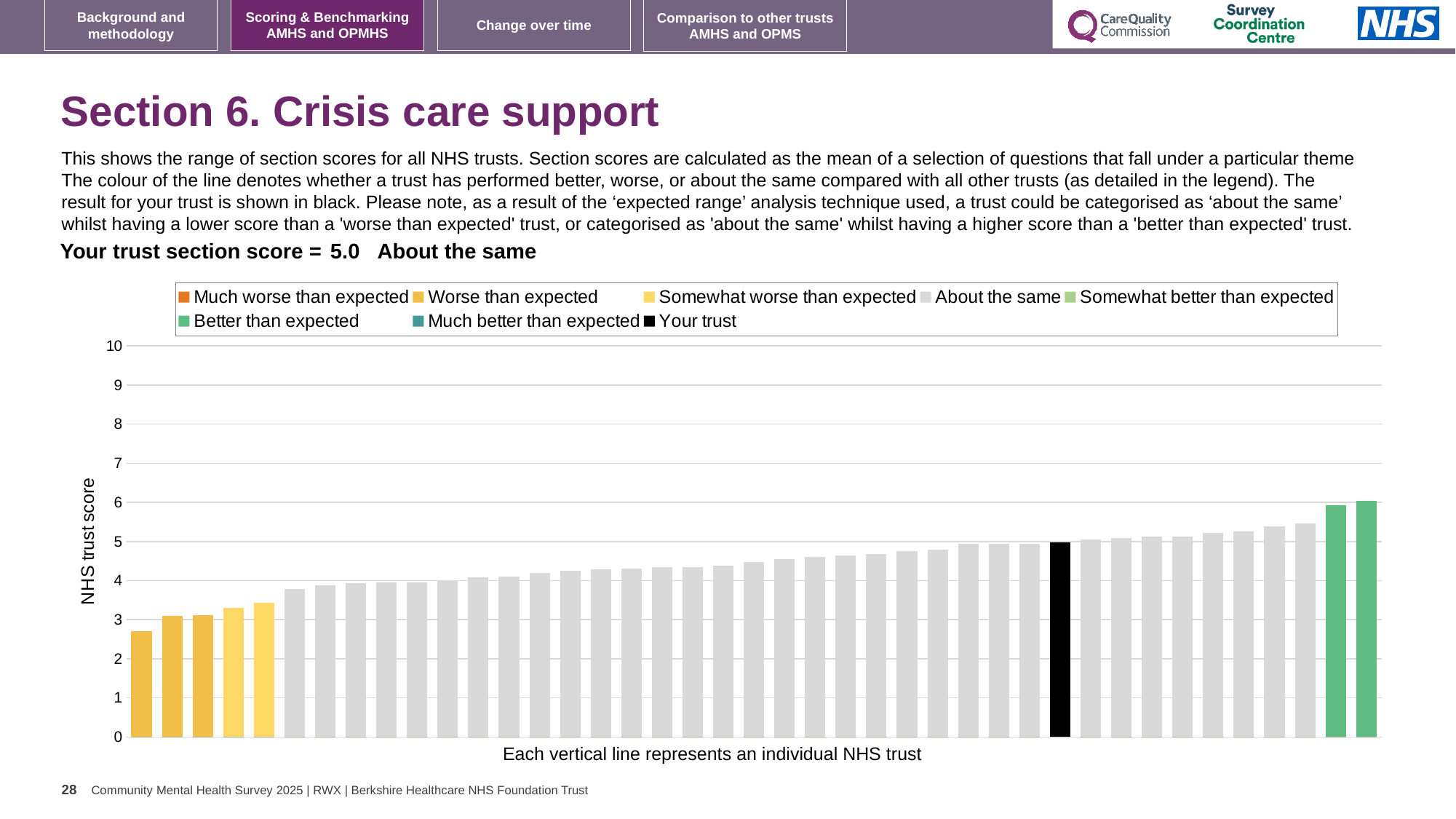
Which performance category is your trust placed in for Section 6? About the same Which is higher: the black 'Your trust' bar or the leftmost bar in the chart? The black 'Your trust' bar How many bars are coloured as 'Worse than expected' (dark yellow)? 3 How many bars are coloured as 'Somewhat worse than expected' (light yellow)? 2 Is the value of the black 'Your trust' bar greater or less than 4? greater What is the title of the vertical axis of the chart? NHS trust score What is the section score for your trust shown on the slide? 5.0 How many entries does the chart legend list? 8 What kind of chart is shown on the slide? Bar chart How many bars are coloured as 'Better than expected' (green)? 2 Is the value of the lowest bar in the chart greater or less than 3? less Do the trust scores rise or fall from left to right across the chart? Rise